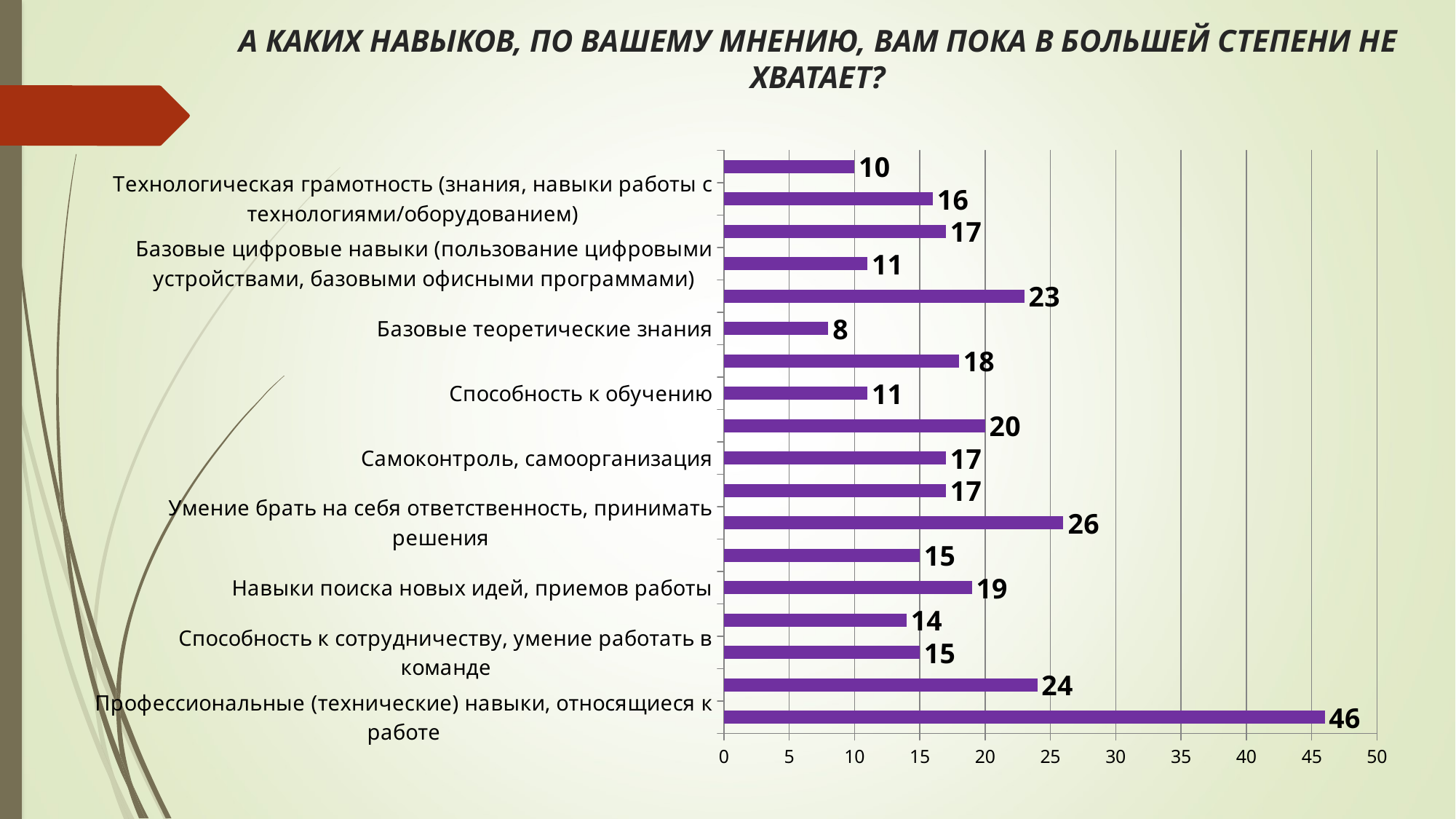
How many bars are plotted in the chart? 18 What is the value for «Базовые теоретические знания»? 8 What is the value for «Профессиональные (технические) навыки, относящиеся к работе»? 46 What is the value for «Самоконтроль, самоорганизация»? 17 What kind of chart is shown on the slide? bar chart Is the value for «Профессиональные (технические) навыки, относящиеся к работе» greater or less than 40? greater Which category has the lowest value? Базовые теоретические знания Which is larger: the value for «Навыки поиска новых идей, приемов работы» or for «Способность к сотрудничеству, умение работать в команде»? Навыки поиска новых идей, приемов работы What is the difference between the values for «Профессиональные (технические) навыки, относящиеся к работе» and «Умение брать на себя ответственность, принимать решения»? 20 What is the value for «Навыки поиска новых идей, приемов работы»? 19 What is the value for «Умение брать на себя ответственность, принимать решения»? 26 Which category has the highest value? Профессиональные (технические) навыки, относящиеся к работе